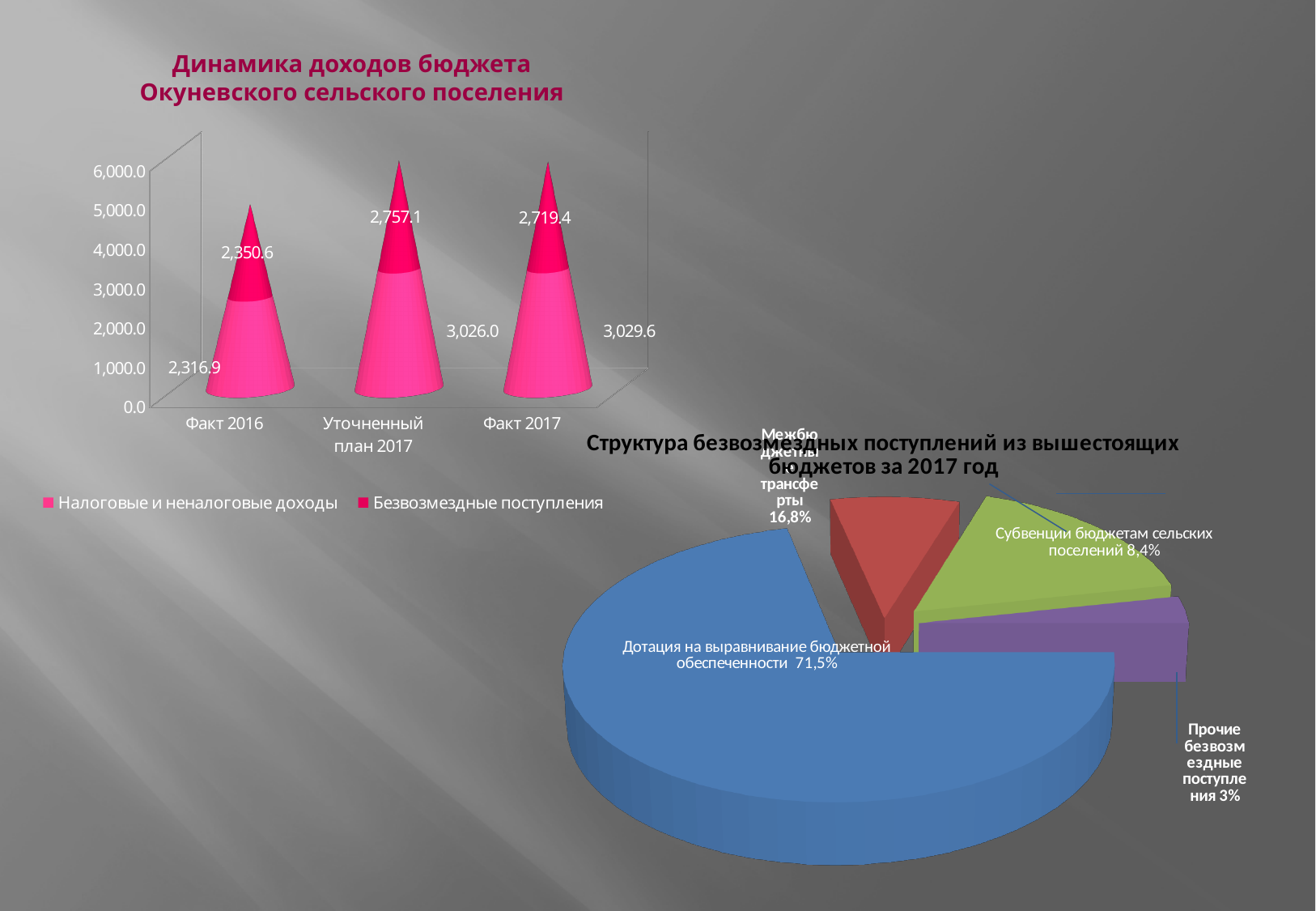
In the pie chart 'Структура безвозмездных поступлений из вышестоящих бюджетов за 2017 год', what share does Дотация на выравнивание бюджетной обеспеченности have? 71,5% What kind of chart is 'Структура безвозмездных поступлений из вышестоящих бюджетов за 2017 год'? Pie chart In the chart 'Динамика доходов бюджета Окуневского сельского поселения', what is the value of Безвозмездные поступления for Уточненный план 2017? 2,757.1 In the pie chart 'Структура безвозмездных поступлений из вышестоящих бюджетов за 2017 год', which slice is the smallest? Прочие безвозмездные поступления In the chart 'Динамика доходов бюджета Окуневского сельского поселения', how many series does the legend list? 2 In the chart 'Динамика доходов бюджета Окуневского сельского поселения', what is the value of Безвозмездные поступления for Факт 2017? 2,719.4 In the chart 'Динамика доходов бюджета Окуневского сельского поселения', what is the difference between Безвозмездные поступления for Уточненный план 2017 and Факт 2017? 37.7 In the chart 'Динамика доходов бюджета Окуневского сельского поселения', how many categories are shown on the x axis? 3 In the chart 'Динамика доходов бюджета Окуневского сельского поселения', which category has the lowest value for Налоговые и неналоговые доходы? Факт 2016 In the chart 'Динамика доходов бюджета Окуневского сельского поселения', what is the value of Налоговые и неналоговые доходы for Факт 2016? 2,316.9 In the chart 'Динамика доходов бюджета Окуневского сельского поселения', what is the total of the stacked bar for Факт 2016? 4,667.5 In the chart 'Динамика доходов бюджета Окуневского сельского поселения', is Безвозмездные поступления larger for Факт 2016 or for Факт 2017? Факт 2017